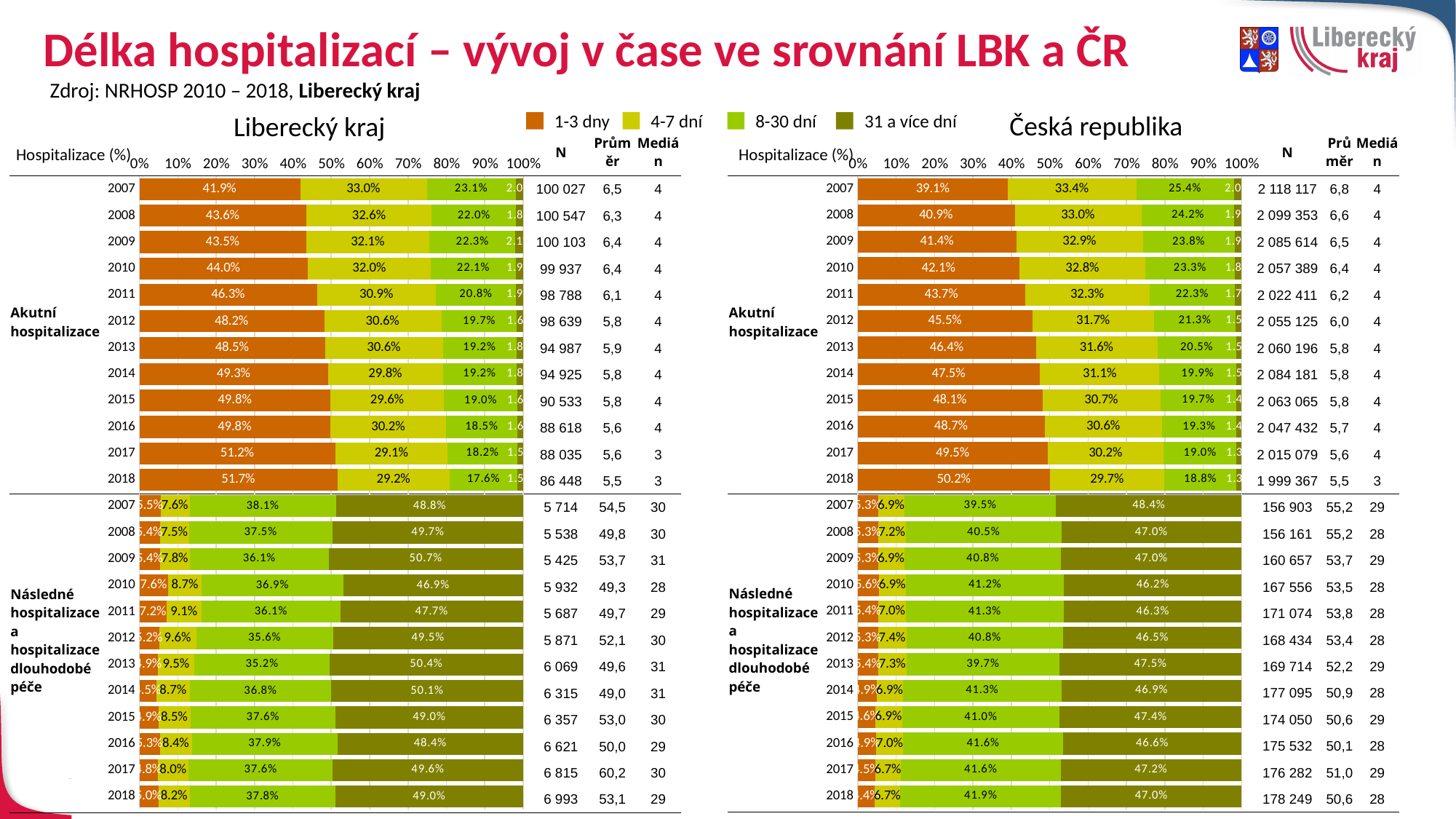
In the Liberecký kraj chart, does the 1-3 dny share for Akutní hospitalizace rise or fall from 2007 to 2018? Rises In the Liberecký kraj chart, by how many percentage points did the 1-3 dny share for Akutní hospitalizace change between 2007 and 2018? 9.8 percentage points In the Liberecký kraj chart, what is the 31 a více dní share for Následné hospitalizace in 2007? 48.8% In the Česká republika chart, does the 8-30 dní share for Akutní hospitalizace rise or fall from 2007 to 2018? Falls How many series does the legend list? 4 How many years are plotted for Akutní hospitalizace in the Liberecký kraj chart? 12 In the Česká republika chart, what is the 8-30 dní share for Následné hospitalizace in 2018? 41.9% In the Liberecký kraj chart, what is the 1-3 dny share for Akutní hospitalizace in 2018? 51.7% For Akutní hospitalizace in 2018, which chart shows the larger 1-3 dny share, Liberecký kraj or Česká republika? Liberecký kraj What kind of chart is used on the slide for Liberecký kraj and Česká republika? Stacked bar chart In the Česká republika chart, what is the 1-3 dny share for Akutní hospitalizace in 2007? 39.1% In the Liberecký kraj chart, which year has the highest 1-3 dny share for Akutní hospitalizace? 2018